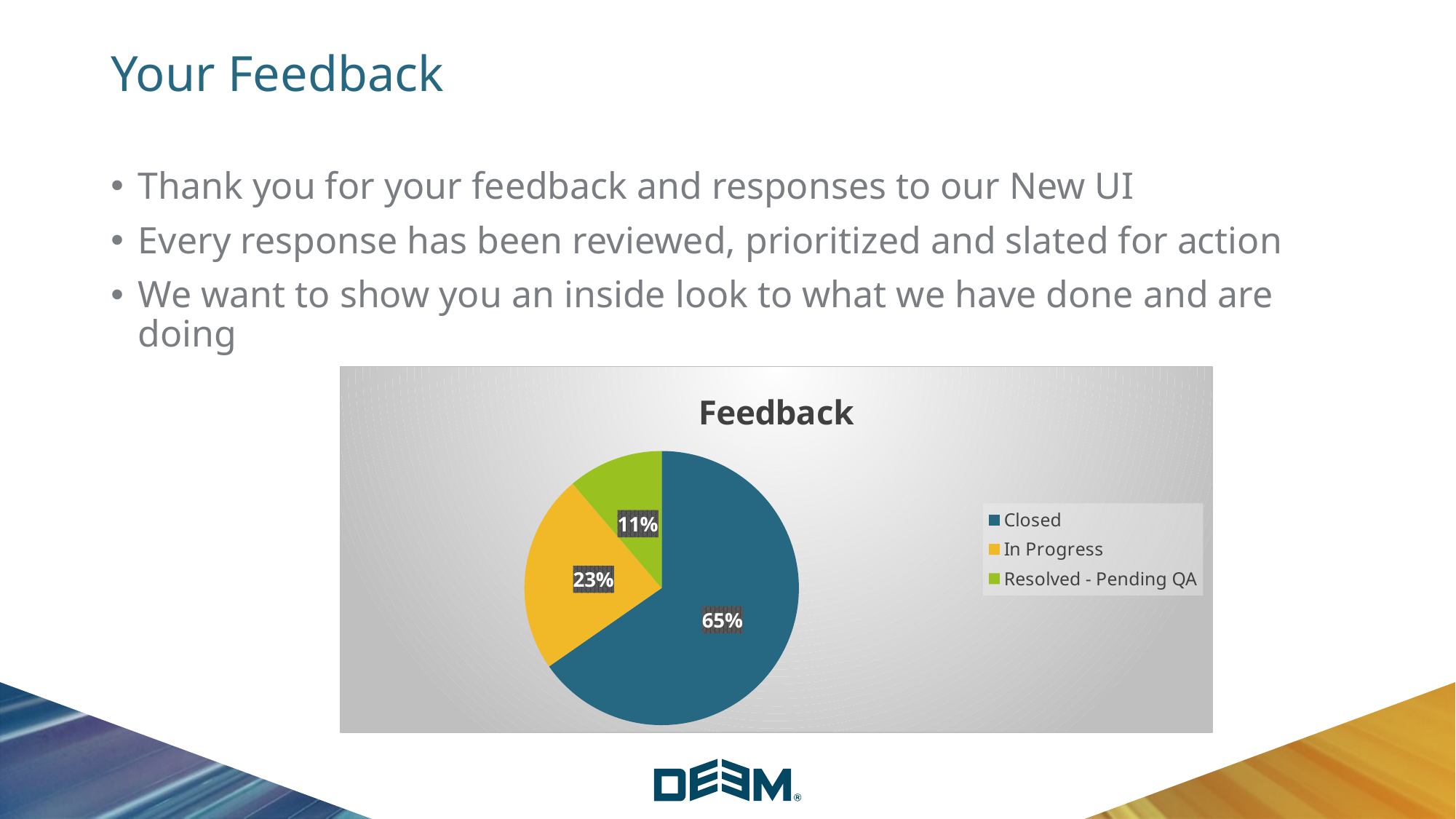
Which category has the smallest slice of the pie? Resolved - Pending QA What is the difference in percentage points between the Closed and In Progress slices? 42 What share of the pie does the Resolved - Pending QA slice represent? 11% What share of the pie does the In Progress slice represent? 23% What is the difference in percentage points between the In Progress and Resolved - Pending QA slices? 12 What share of the pie does the Closed slice represent? 65% How many categories are shown in the pie chart? 3 Which category has the largest slice of the pie? Closed Which is larger, the In Progress slice or the Resolved - Pending QA slice? In Progress Which colour represents the In Progress category in the legend? Yellow What is the title of the chart? Feedback What kind of chart is shown on the slide? Pie chart